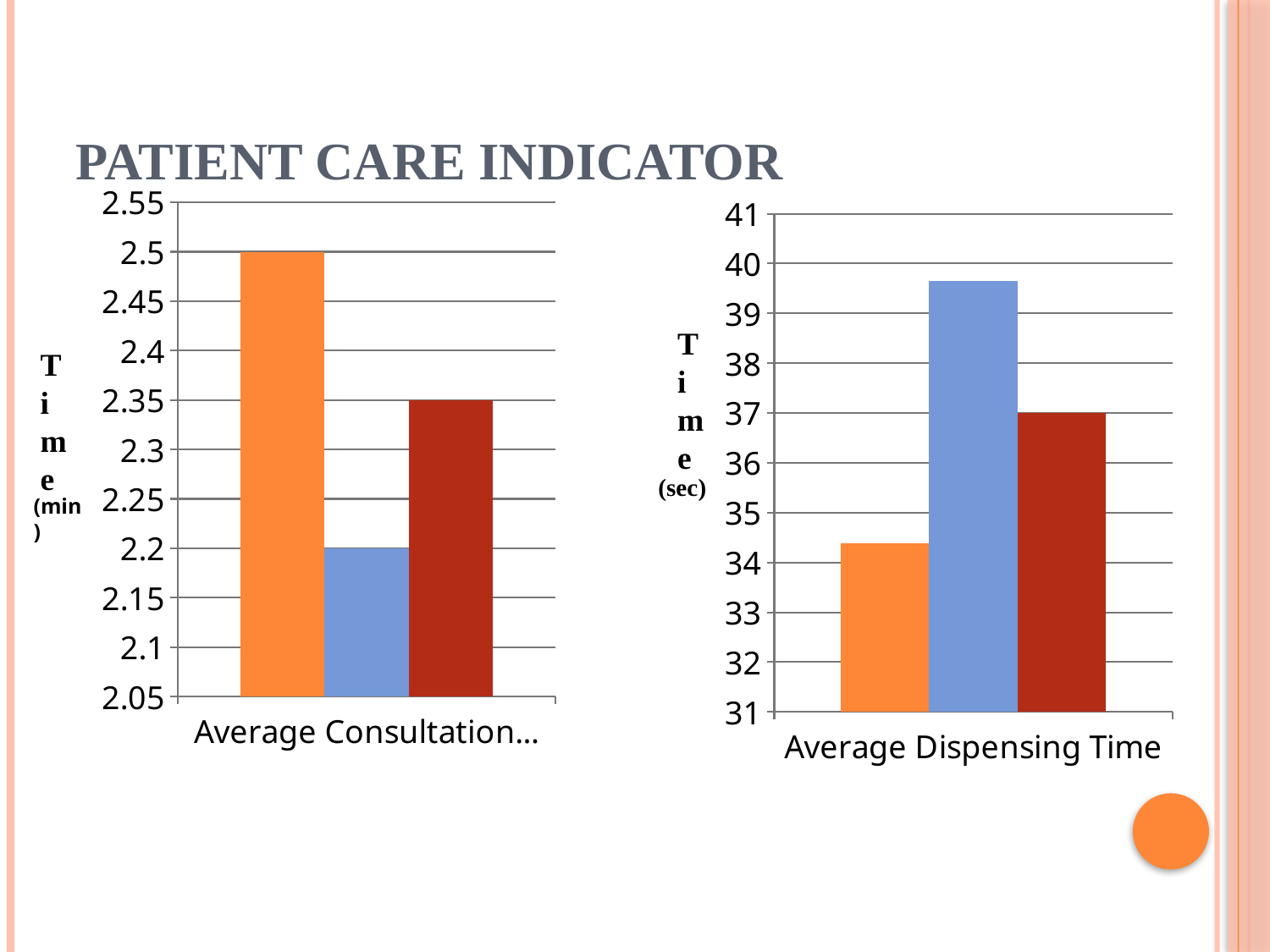
In the left chart (Average Consultation), what is the difference between the orange bar and the blue bar? 0.3 What kind of chart is the left chart on the slide? bar chart In the right chart (Average Dispensing Time), what value does the dark red bar reach? 37 In the right chart (Average Dispensing Time), is the value for the blue bar greater or less than 39? greater In the left chart (Average Consultation), which coloured bar is the highest? orange In the left chart (Average Consultation), what value does the dark red bar reach? 2.35 How many bars are plotted in the right chart (Average Dispensing Time)? 3 In the right chart (Average Dispensing Time), which coloured bar is the highest? blue In the right chart (Average Dispensing Time), is the value for the orange bar greater or less than 35? less In the left chart (Average Consultation), what value does the orange bar reach? 2.5 In the left chart (Average Consultation), what value does the blue bar reach? 2.2 In the left chart (Average Consultation), which coloured bar is the lowest? blue